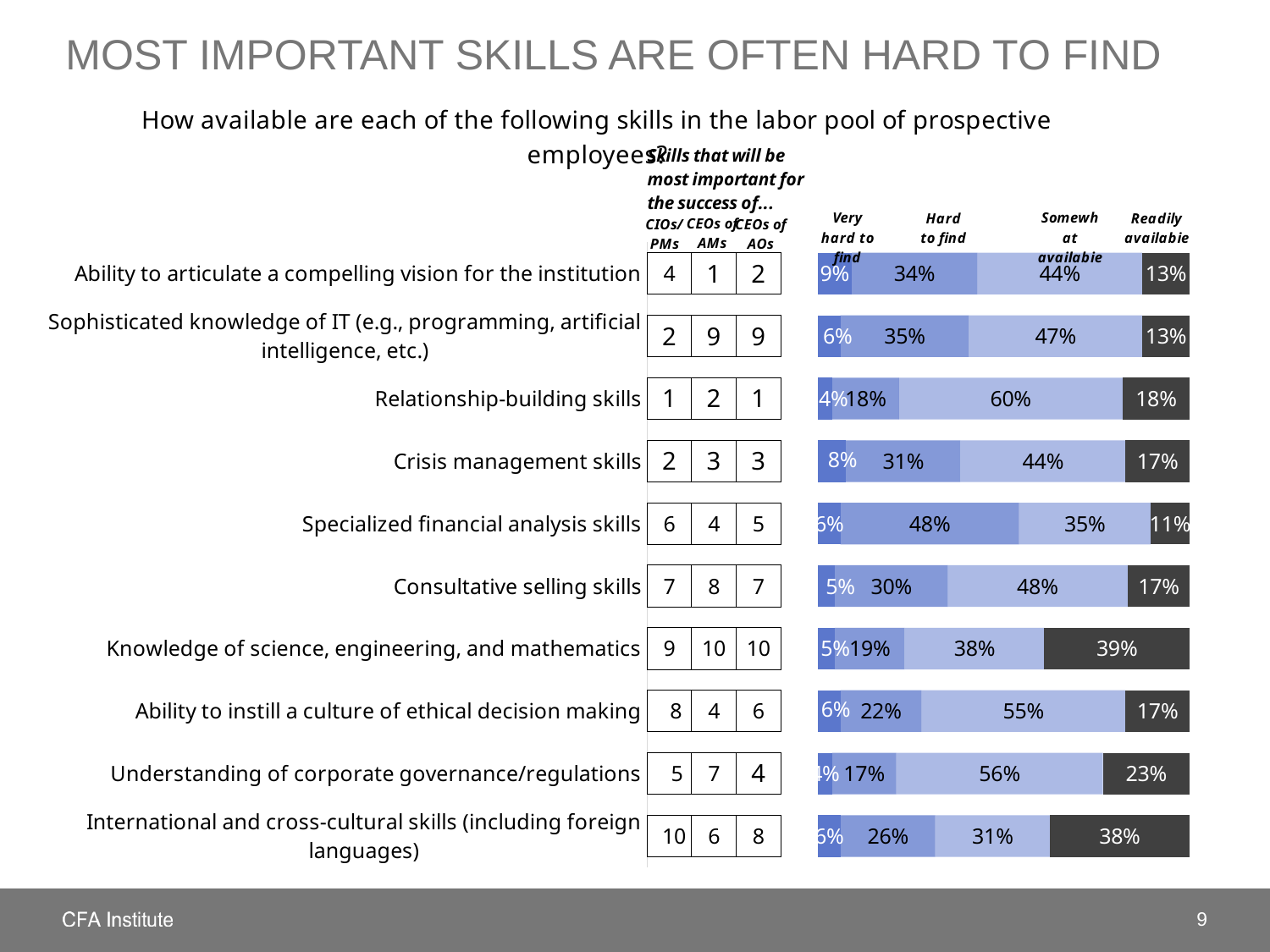
What type of chart is used to show skill availability? Stacked bar chart What is the difference between the 'Hard to find' percentages for sophisticated knowledge of IT and relationship-building skills? 17% Which skill has the lowest 'Readily available' percentage? Specialized financial analysis skills What percentage of respondents said the ability to articulate a compelling vision for the institution is very hard to find? 9% What percentage of respondents said relationship-building skills are somewhat available in the labor pool? 60% Which has a larger 'Readily available' percentage: international and cross-cultural skills or understanding of corporate governance/regulations? International and cross-cultural skills How many response categories (series) does the chart show for each skill? 4 What percentage of respondents said specialized financial analysis skills are hard to find? 48% What percentage of respondents said knowledge of science, engineering, and mathematics is readily available? 39% What is the total of the four percentages shown for relationship-building skills? 100% How many skills are listed in the chart? 10 Which skill has the highest 'Somewhat available' percentage? Relationship-building skills